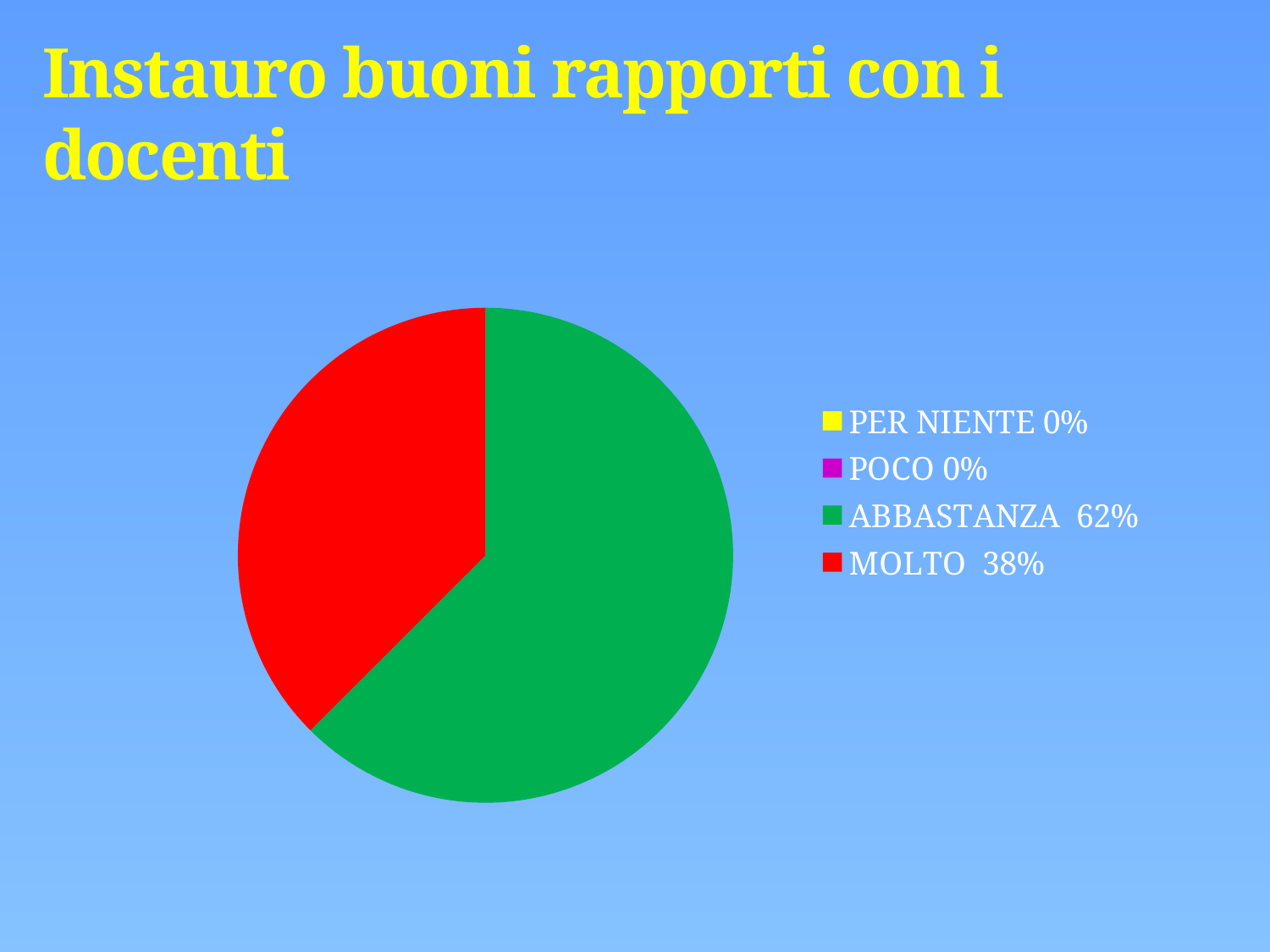
What is the difference in percentage points between ABBASTANZA and MOLTO? 24 What percentage is shown for MOLTO? 38% What is the combined share of ABBASTANZA and MOLTO? 100% How many entries does the legend list? 4 What colour is the slice for MOLTO? red What is the title of the slide containing the chart? Instauro buoni rapporti con i docenti What percentage is shown for PER NIENTE? 0% What kind of chart is shown on the slide? pie chart What percentage is shown for POCO? 0% Which is larger, the share for MOLTO or the share for ABBASTANZA? ABBASTANZA Which category has the largest share of the pie? ABBASTANZA What percentage is shown for ABBASTANZA? 62%